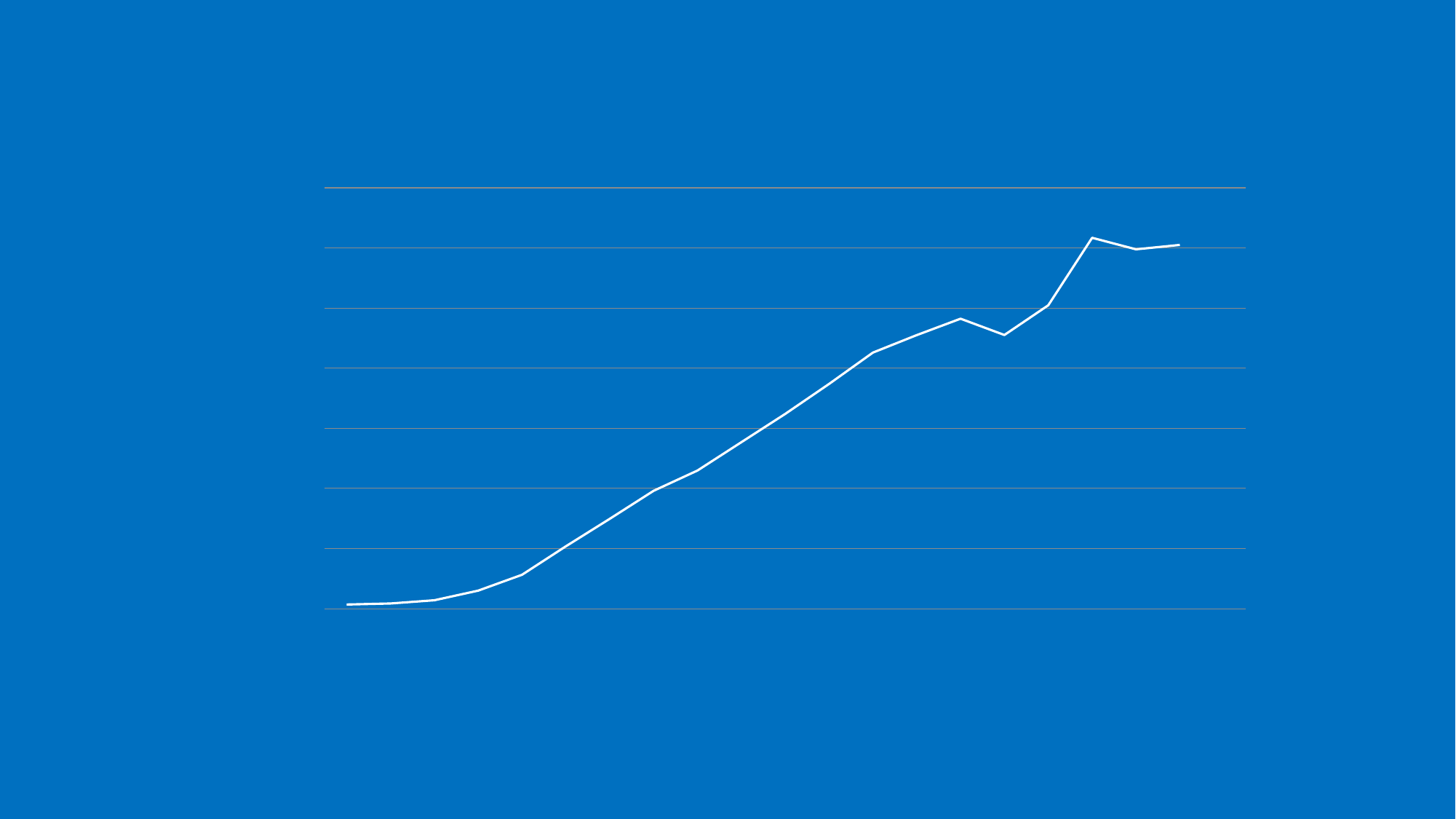
How many horizontal gridlines does the chart show? 8 What kind of chart is shown on the slide? line chart What colour is the plotted line? white Do the values of the line generally rise or fall from left to right? rise